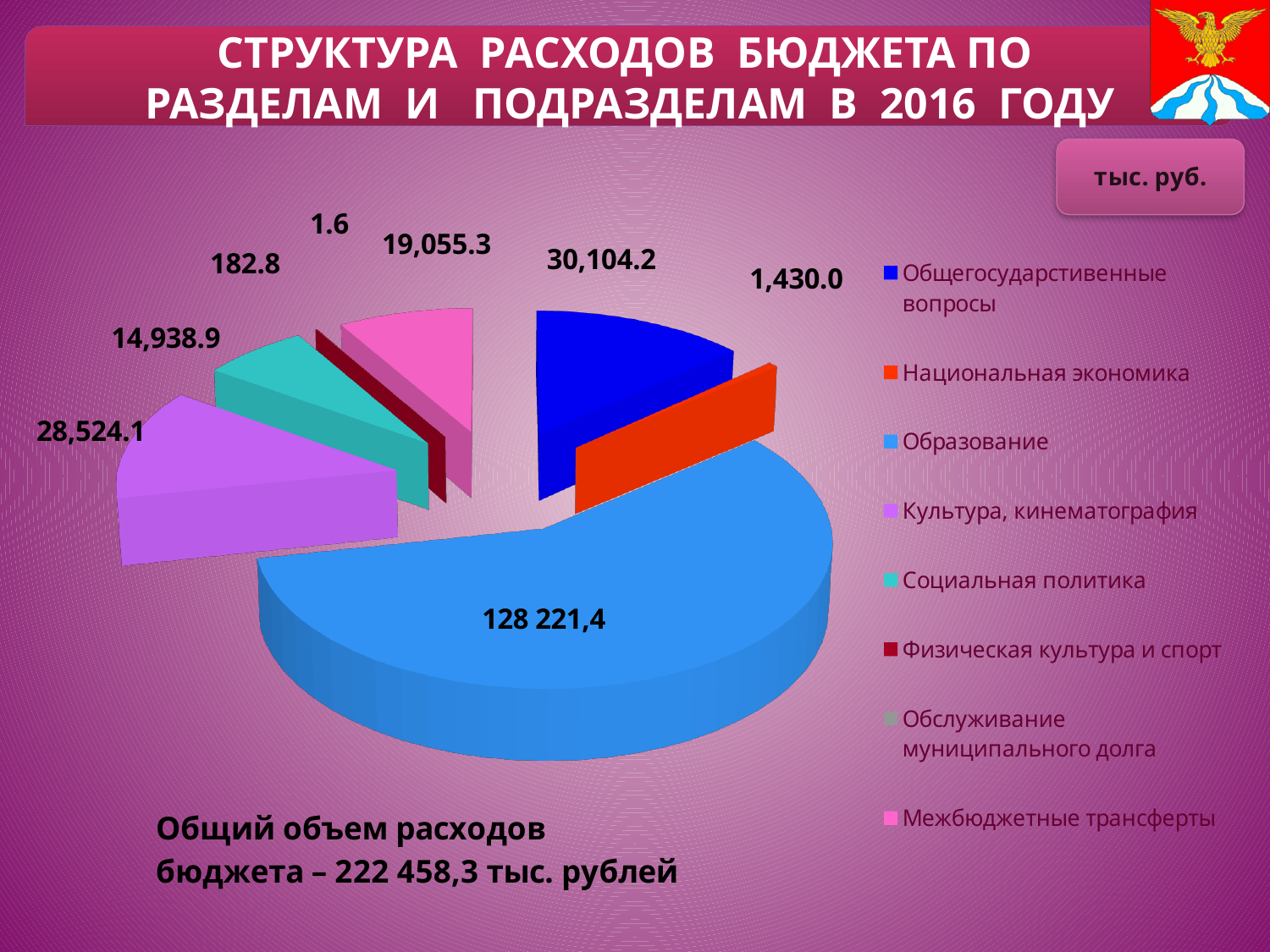
What kind of chart is shown on the slide? pie chart Which is larger, the value for Общегосударственные вопросы or the value for Культура, кинематография? Общегосударственные вопросы What unit of measurement is indicated for the chart values? тыс. руб. How many categories does the legend of the pie chart list? 8 What is the value shown for Культура, кинематография? 28,524.1 Which category has the largest slice of the pie? Образование What is the value shown for Межбюджетные трансферты? 19,055.3 What is the value shown for Общегосударственные вопросы? 30,104.2 Which category has the smallest value in the pie chart? Обслуживание муниципального долга What is the value shown for Обслуживание муниципального долга? 1.6 What is the value shown for Образование? 128 221,4 What is the value shown for Социальная политика? 14,938.9